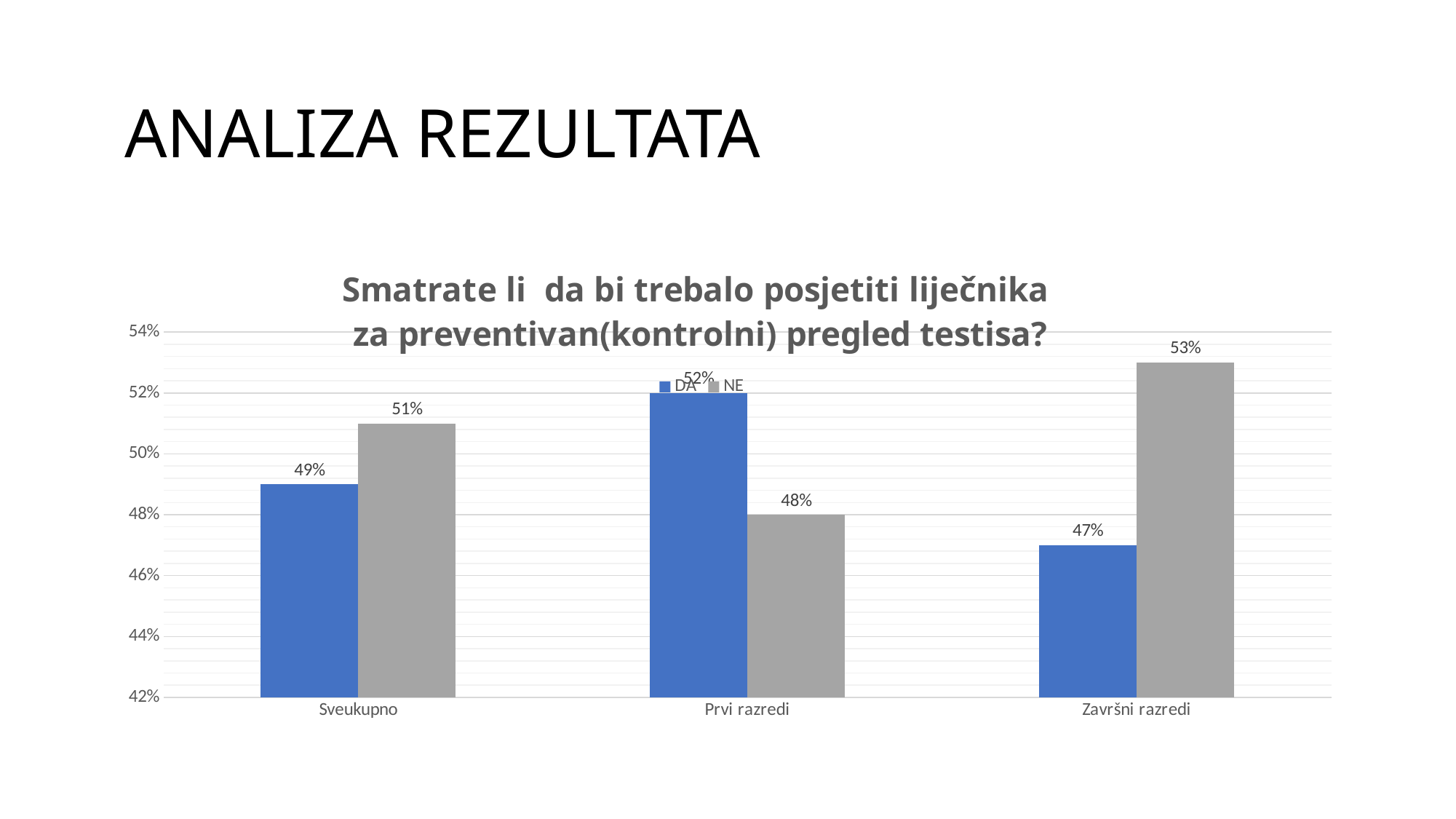
What is the value for DA in the Sveukupno category? 49% Which colour represents the NE series? Grey What is the value for NE in the Završni razredi category? 53% What kind of chart is shown on the slide? Bar chart What is the difference between the NE and DA values in the Završni razredi category? 6% What is the value for DA in the Završni razredi category? 47% Which category has the lowest DA value? Završni razredi In the Prvi razredi category, which is larger, DA or NE? DA How many series does the legend list? 2 What is the value for NE in the Prvi razredi category? 48% Which category has the highest NE value? Završni razredi How many categories are shown on the x axis? 3